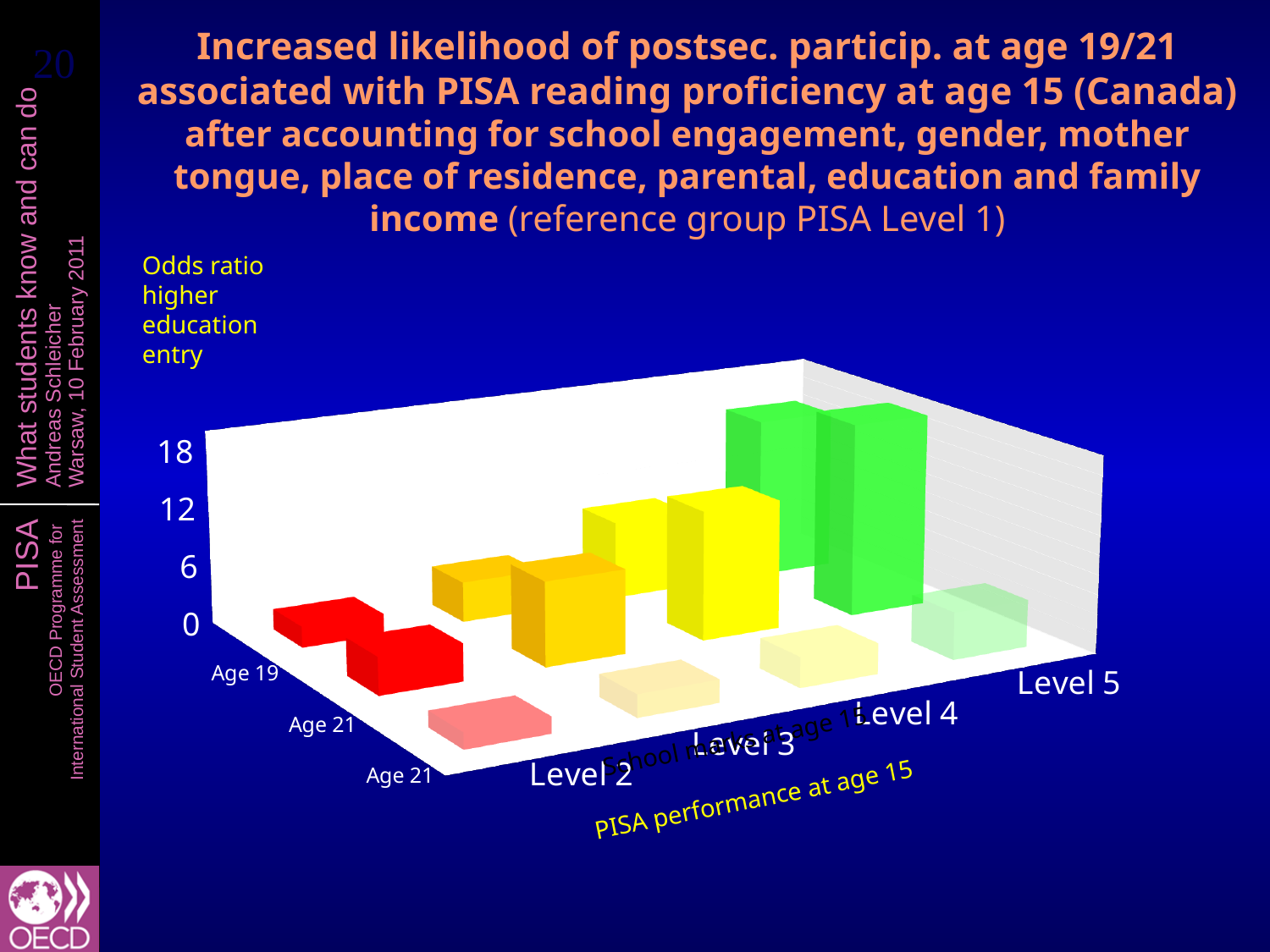
What is the label of the horizontal axis of the chart? PISA performance at age 15 Which PISA performance level has the highest odds ratio bars in the chart? Level 5 Which PISA performance level has the lowest odds ratio bars in the chart? Level 2 How many PISA performance levels are shown along the x axis of the chart? 4 Is the odds ratio for Level 2 at Age 19 greater or less than 6? less Which has a larger odds ratio at Age 19: Level 3 or Level 2? Level 3 Do the odds ratio bars rise or fall from Level 2 to Level 4? rise What is the label of the vertical axis of the chart? Odds ratio higher education entry What kind of chart is shown on the slide? bar chart